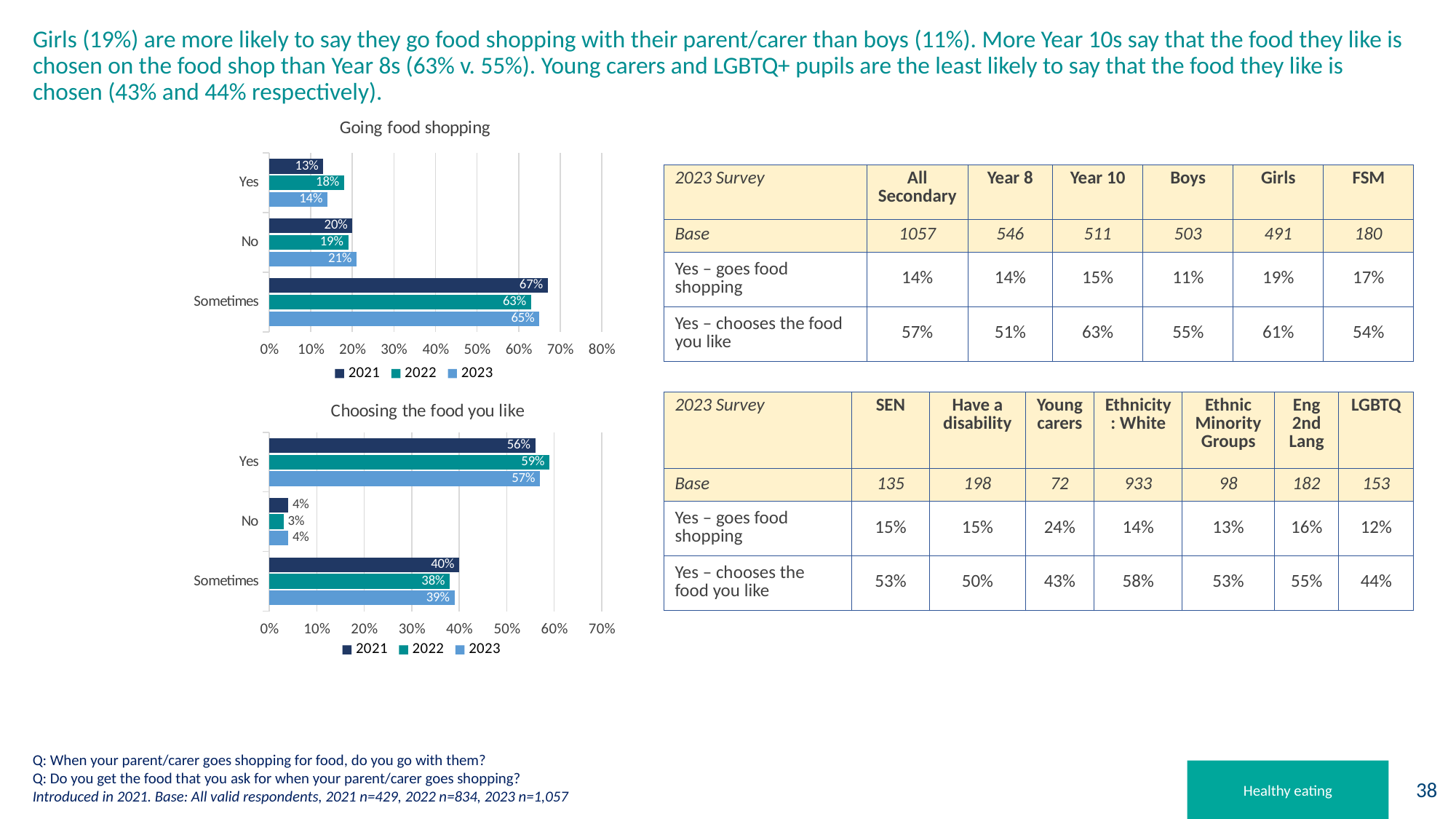
In the 'Going food shopping' chart, what is the difference between the 2022 and 2021 values for Yes? 5% How many series does the legend of the 'Going food shopping' chart list? 3 In the 'Choosing the food you like' chart, which is larger for Yes: the 2021 value or the 2022 value? 2022 In the 'Choosing the food you like' chart, what is the 2022 value for No? 3% How many categories are shown on the 'Choosing the food you like' chart? 3 In the 'Going food shopping' chart, which category has the highest 2021 value? Sometimes In the 'Choosing the food you like' chart, which category has the lowest 2023 value? No What kind of chart is the 'Going food shopping' chart? Bar chart In the 'Choosing the food you like' chart, what is the 2021 value for Sometimes? 40% In the 'Going food shopping' chart, what is the difference between the 2021 and 2023 values for Sometimes? 2% In the 'Going food shopping' chart, what is the 2023 value for Yes? 14% In the 'Going food shopping' chart, what is the 2022 value for Sometimes? 63%